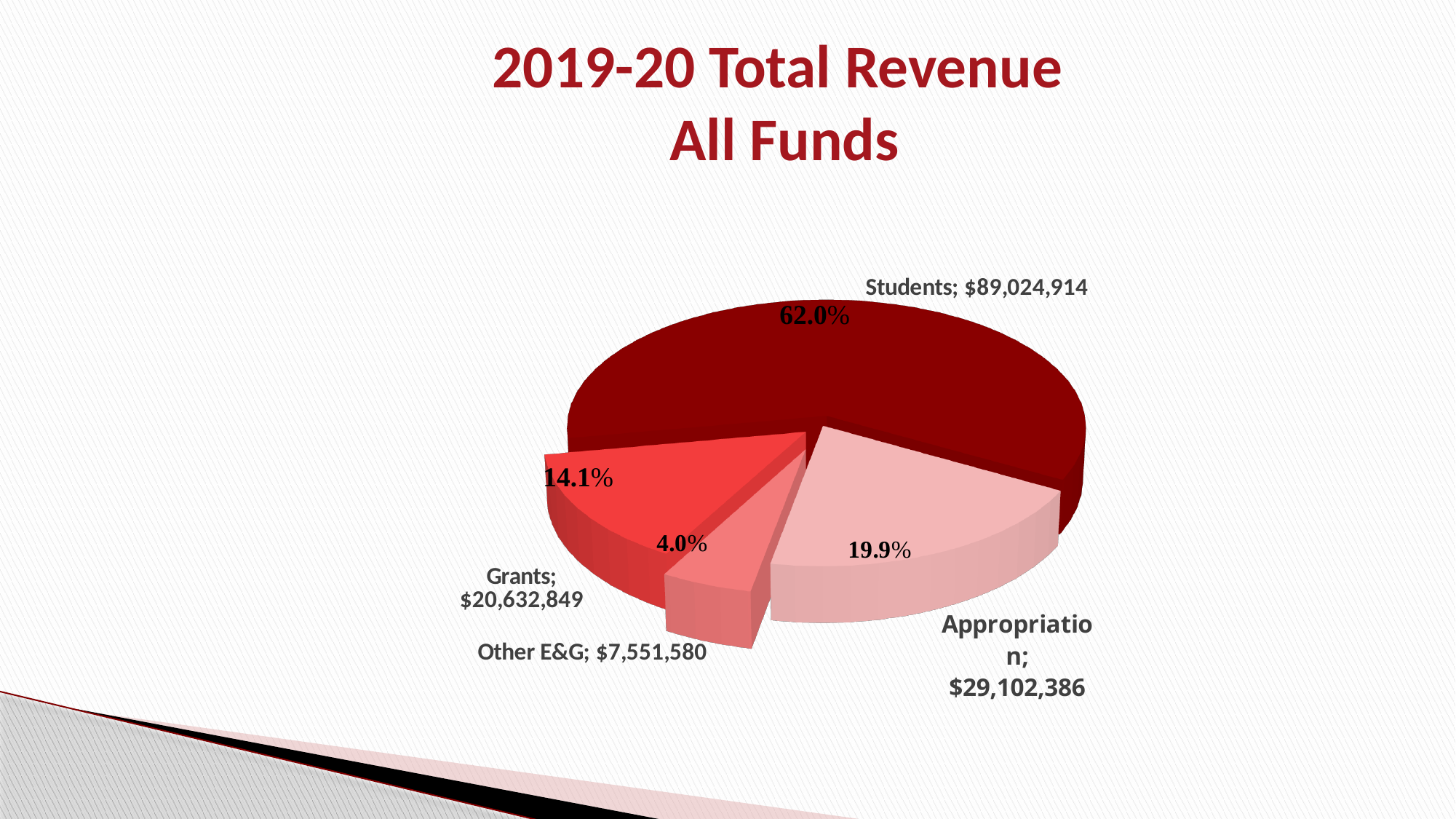
What is the revenue value for Other E&G? $7,551,580 What type of chart is shown on the slide? Pie chart How many categories are shown in the pie chart? 4 What is the difference between the Grants revenue and the Other E&G revenue? $13,081,269 Which category has the smallest share of revenue? Other E&G What is the revenue value for Grants? $20,632,849 Which is larger, the revenue from Appropriation or from Grants? Appropriation Which category has the largest share of revenue? Students What share of total revenue comes from Grants? 14.1% What share of total revenue comes from Students? 62.0% What is the revenue value for Students? $89,024,914 What is the revenue value for Appropriation? $29,102,386